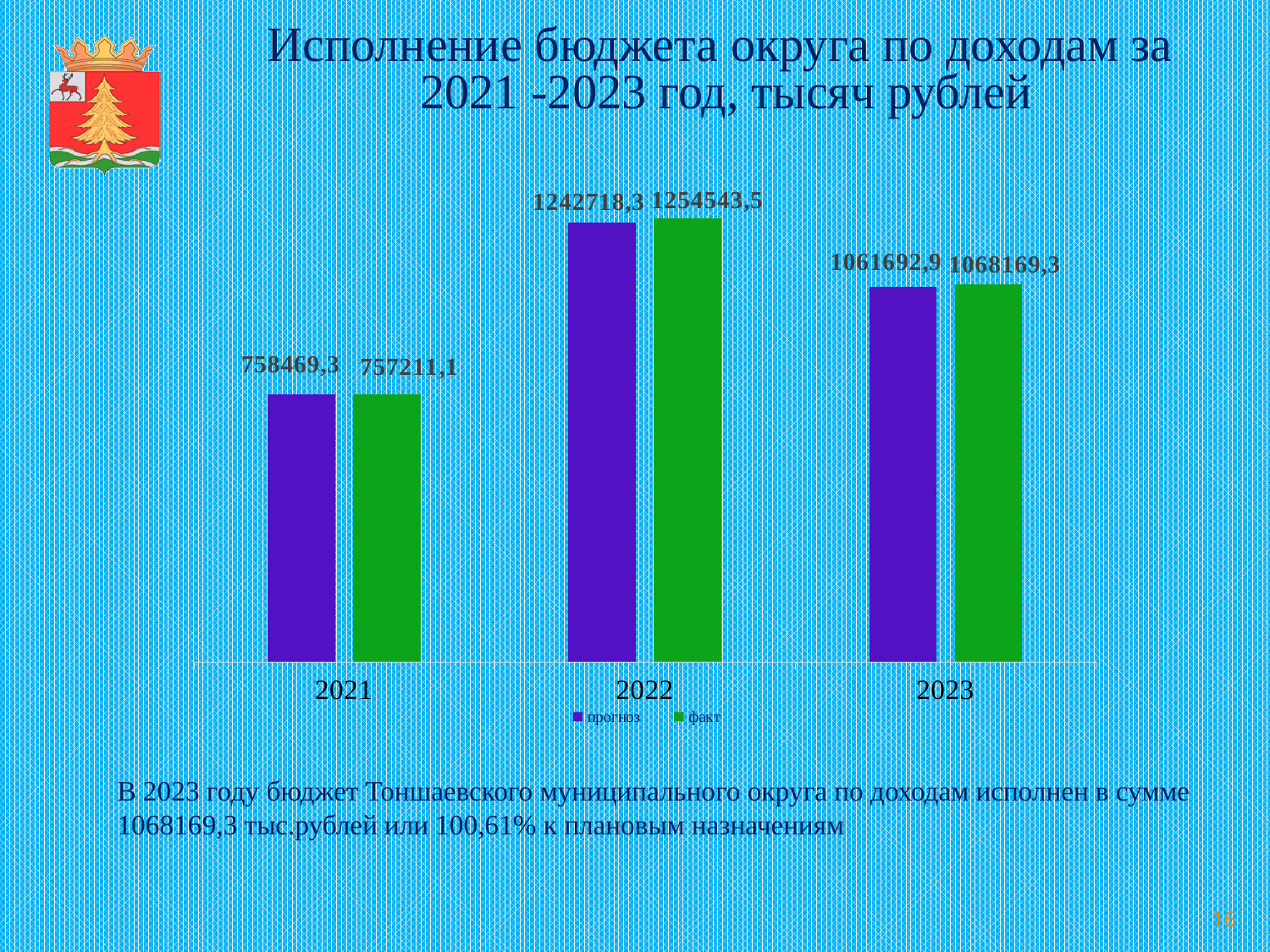
Which is larger, the факт value for 2022 or the факт value for 2023? 2022 How many years are shown on the x axis? 3 What kind of chart is shown on the slide? Bar chart Which year has the highest факт value? 2022 How many series does the legend list? 2 What is the value of прогноз for 2022? 1242718,3 What is the difference between факт and прогноз for 2023? 6476,4 What is the value of факт for 2021? 757211,1 What is the value of прогноз for 2021? 758469,3 What is the value of факт for 2023? 1068169,3 Which year has the lowest прогноз value? 2021 What is the difference between факт and прогноз for 2022? 11825,2